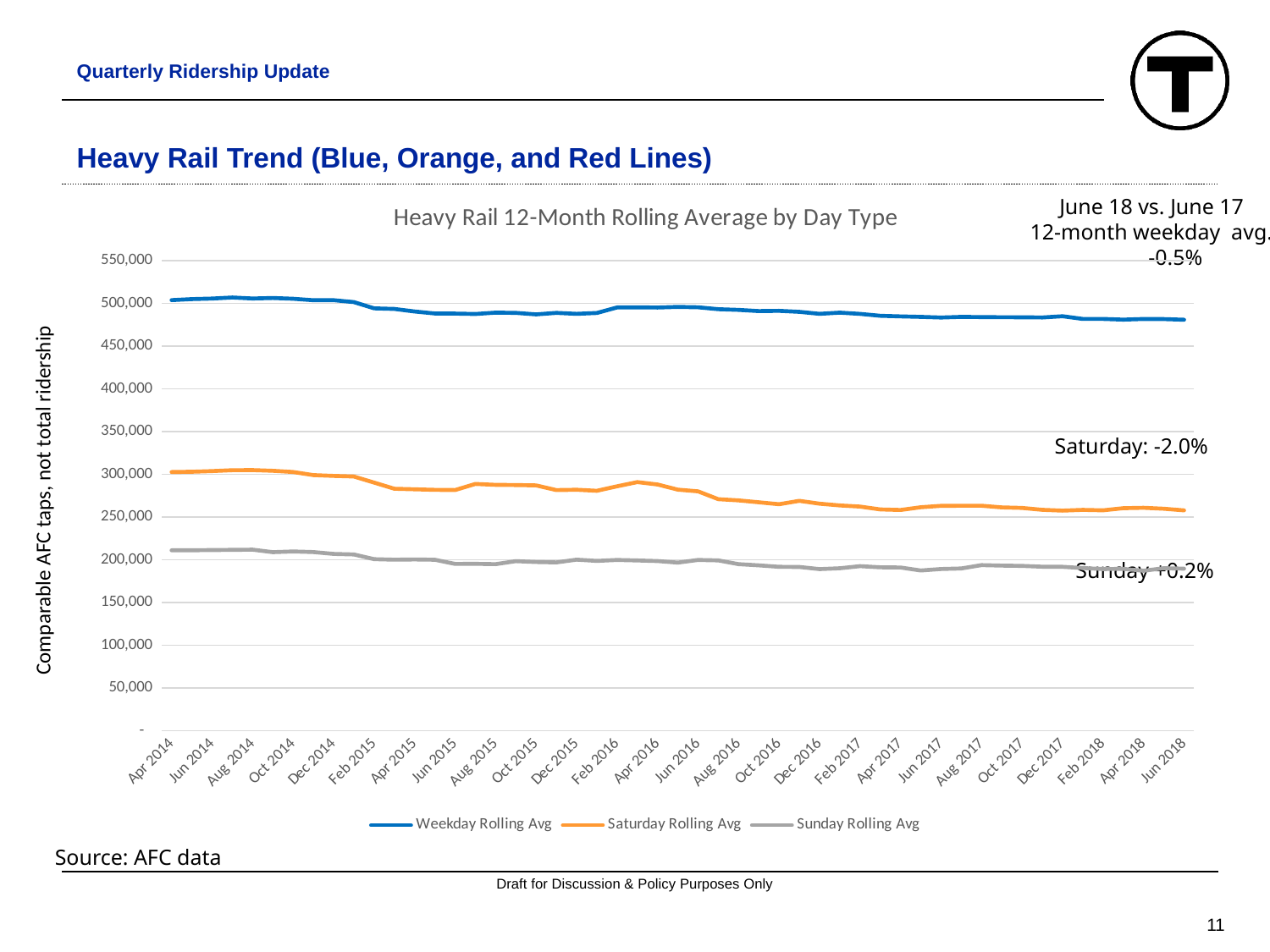
Is the Sunday Rolling Avg value for Apr 2014 greater or less than 200,000? greater Does the Saturday Rolling Avg rise or fall from Apr 2014 to Jun 2018? fall What colour is the line for the Saturday Rolling Avg? orange Which series has the lowest values throughout the chart? Sunday Rolling Avg How many series does the legend list? 3 Which series has the highest values throughout the chart? Weekday Rolling Avg Does the Weekday Rolling Avg rise or fall from Apr 2014 to Jun 2018? fall Is the Weekday Rolling Avg value for Jun 2018 greater or less than 500,000? less What kind of chart is shown on the slide? line chart What is the title of the chart? Heavy Rail 12-Month Rolling Average by Day Type Is the Saturday Rolling Avg value for Jun 2018 greater or less than 250,000? greater Which is larger in Jun 2018, the Saturday Rolling Avg or the Sunday Rolling Avg? Saturday Rolling Avg